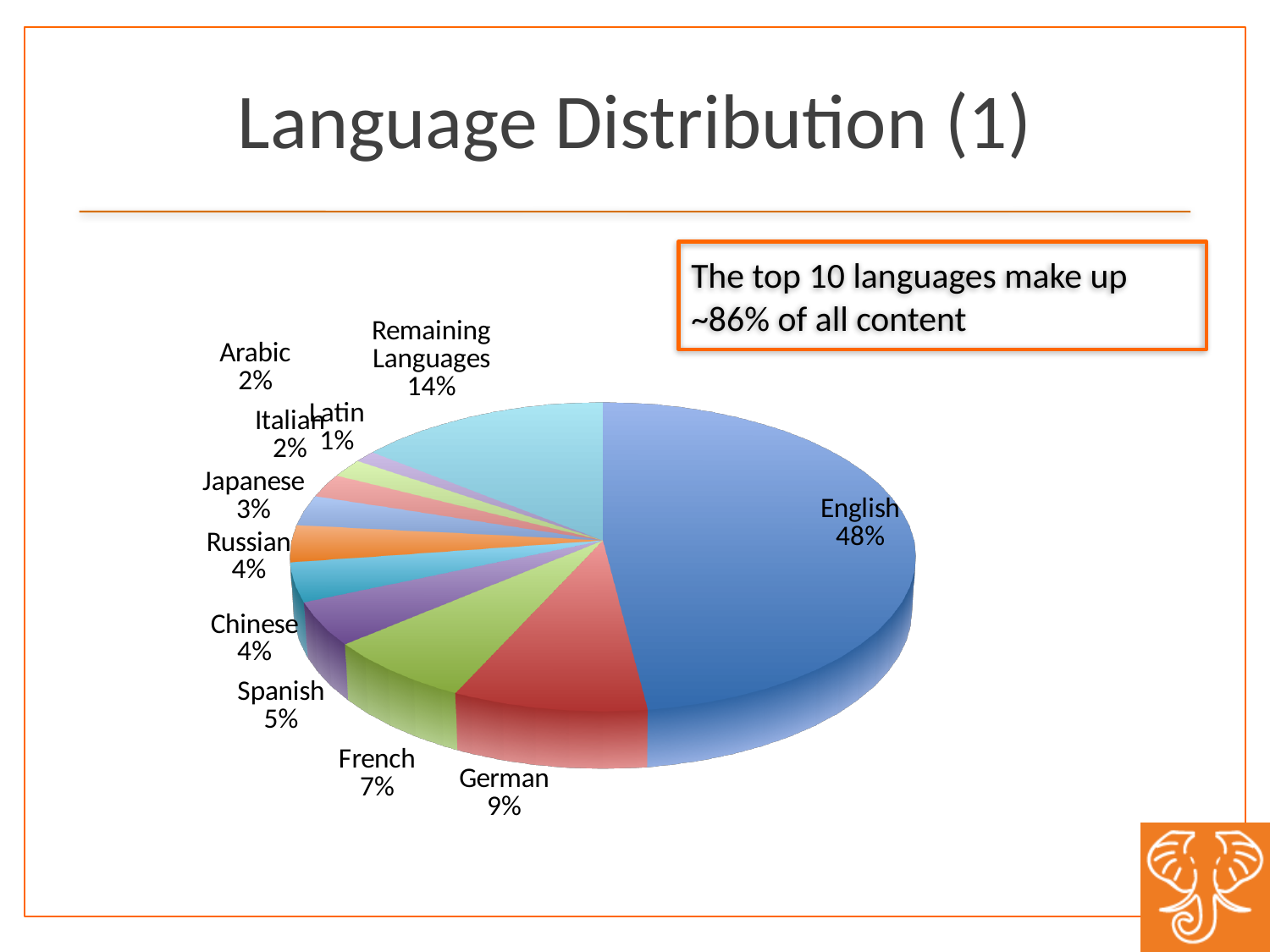
What is the value shown for German? 9% Which language has the smallest slice of the pie? Latin What is the difference between the shares for English and German? 39% What is the title of the slide containing the pie chart? Language Distribution (1) How many slices does the pie chart have? 11 What kind of chart is shown on the slide? pie chart What share of the pie does English account for? 48% Which slice of the pie is the largest? English What is the value shown for Remaining Languages? 14% What is the value shown for Japanese? 3% What is the difference between the shares for French and Spanish? 2% Which is larger, the share for French or the share for Chinese? French